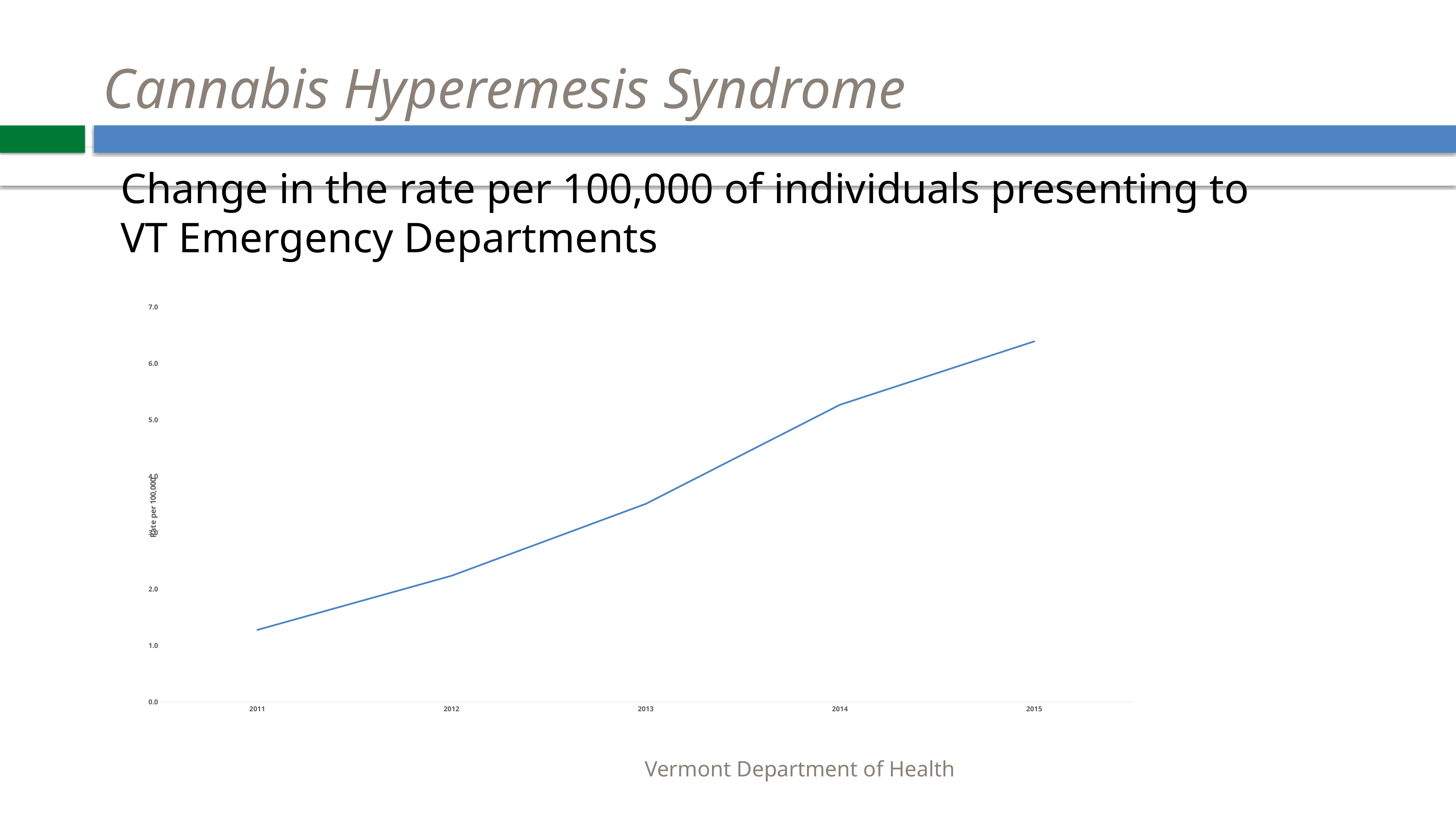
Which year has the larger rate, 2012 or 2014? 2014 Is the value for 2014 greater or less than 5.0? greater Does the rate rise or fall from 2011 to 2015? rises What is the highest tick value shown on the y axis? 7.0 What kind of chart is shown on the slide? line chart Is the value for 2015 greater or less than 6.0? greater What is the label on the y axis of the chart? Rate per 100,000 Is the value for 2013 greater or less than 4.0? less Which year has the highest rate per 100,000? 2015 Which year has the lowest rate per 100,000? 2011 How many years are plotted along the x axis of the chart? 5